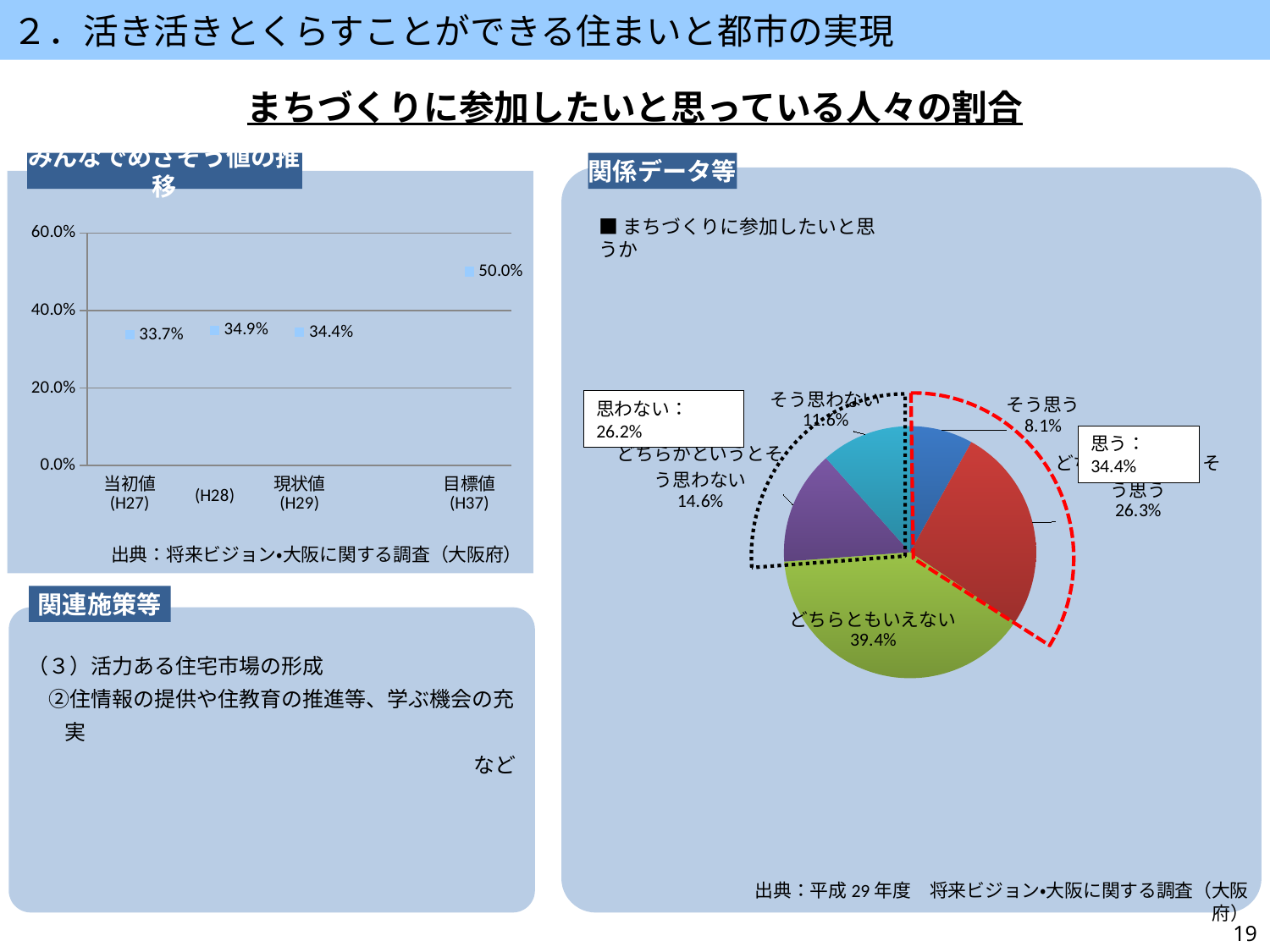
In the pie chart on the right (まちづくりに参加したいと思うか), what is the share for そう思う? 8.1% In the left chart (みんなでめざそう値の推移), which category has the highest value? 目標値 (H37) In the left chart (みんなでめざそう値の推移), what is the value for 現状値 (H29)? 34.4% In the left chart (みんなでめざそう値の推移), what is the value for 当初値 (H27)? 33.7% In the pie chart on the right (まちづくりに参加したいと思うか), what is the share for どちらともいえない? 39.4% In the pie chart on the right (まちづくりに参加したいと思うか), which slice is the largest? どちらともいえない In the left chart (みんなでめざそう値の推移), how many data points are plotted? 4 In the left chart (みんなでめざそう値の推移), what is the difference between the 目標値 (H37) value and the 現状値 (H29) value? 15.6% In the left chart (みんなでめざそう値の推移), which category has the lowest value? 当初値 (H27) In the left chart (みんなでめざそう値の推移), what is the value for 目標値 (H37)? 50.0% What kind of chart is shown on the right side of the slide? pie chart